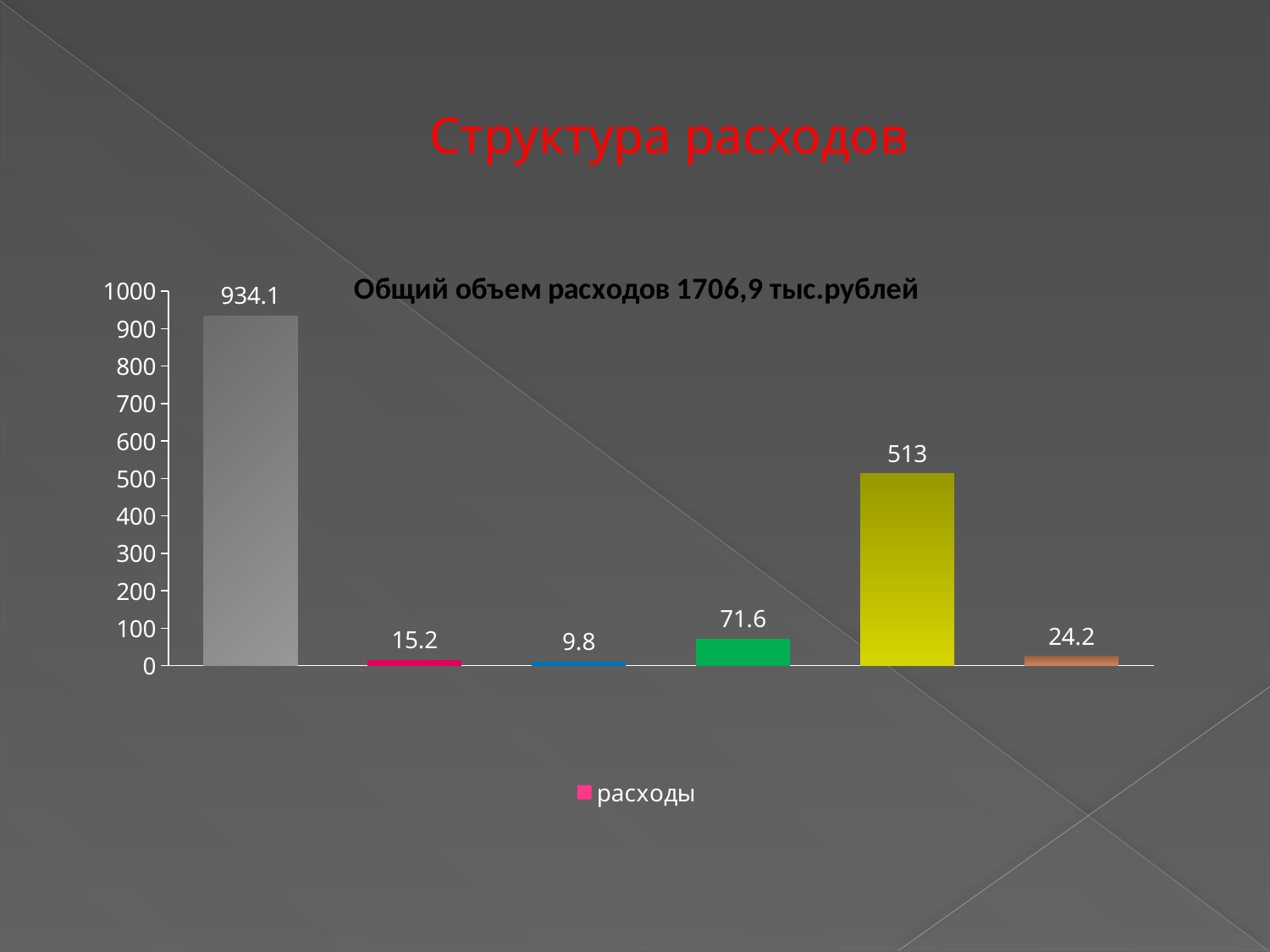
How many bars are plotted in the chart? 6 What type of chart is shown on the slide? bar chart What is the value of the first (grey) bar on the left? 934.1 Which bar has the highest value? the grey bar (934.1) What is the chart's title? Общий объем расходов 1706,9 тыс.рублей What is the value of the yellow bar (fifth from the left)? 513 Which bar has the lowest value? the blue bar (9.8) What is the value of the green bar (fourth from the left)? 71.6 Which is larger, the pink bar (15.2) or the brown bar (24.2)? the brown bar (24.2) What is the value of the blue bar (third from the left)? 9.8 How many series does the legend list? 1 What is the difference between the grey bar (934.1) and the yellow bar (513)? 421.1